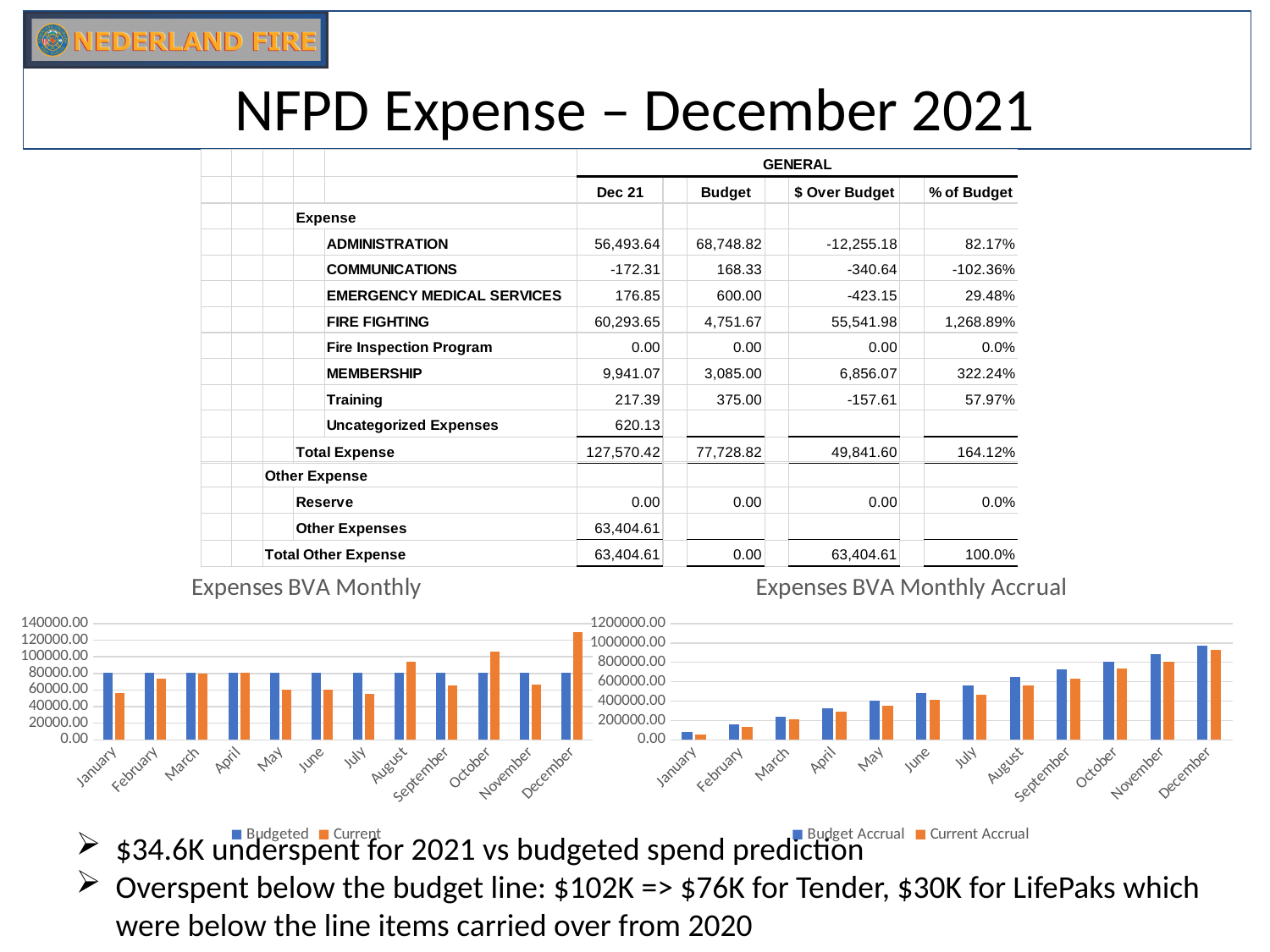
In the "Expenses BVA Monthly Accrual" chart, which month has the highest Current Accrual value? December How many months are shown on the x axis of the "Expenses BVA Monthly Accrual" chart? 12 In the "Expenses BVA Monthly" chart, which month has the highest Current value? December In the "Expenses BVA Monthly" chart, which is larger for May, Budgeted or Current? Budgeted In the "Expenses BVA Monthly" chart, which is larger for December, Budgeted or Current? Current In the "Expenses BVA Monthly" chart, is the Current value for January greater or less than 60000? less What kind of chart is the "Expenses BVA Monthly" chart? bar chart In the "Expenses BVA Monthly Accrual" chart, is the Budget Accrual value for December greater or less than 800000? greater In the "Expenses BVA Monthly Accrual" chart, do the Budget Accrual values rise or fall from January to December? rise How many series does the legend of the "Expenses BVA Monthly" chart list? 2 What are the two legend entries of the "Expenses BVA Monthly Accrual" chart? Budget Accrual and Current Accrual In the "Expenses BVA Monthly" chart, is the Current value for December greater or less than 100000? greater